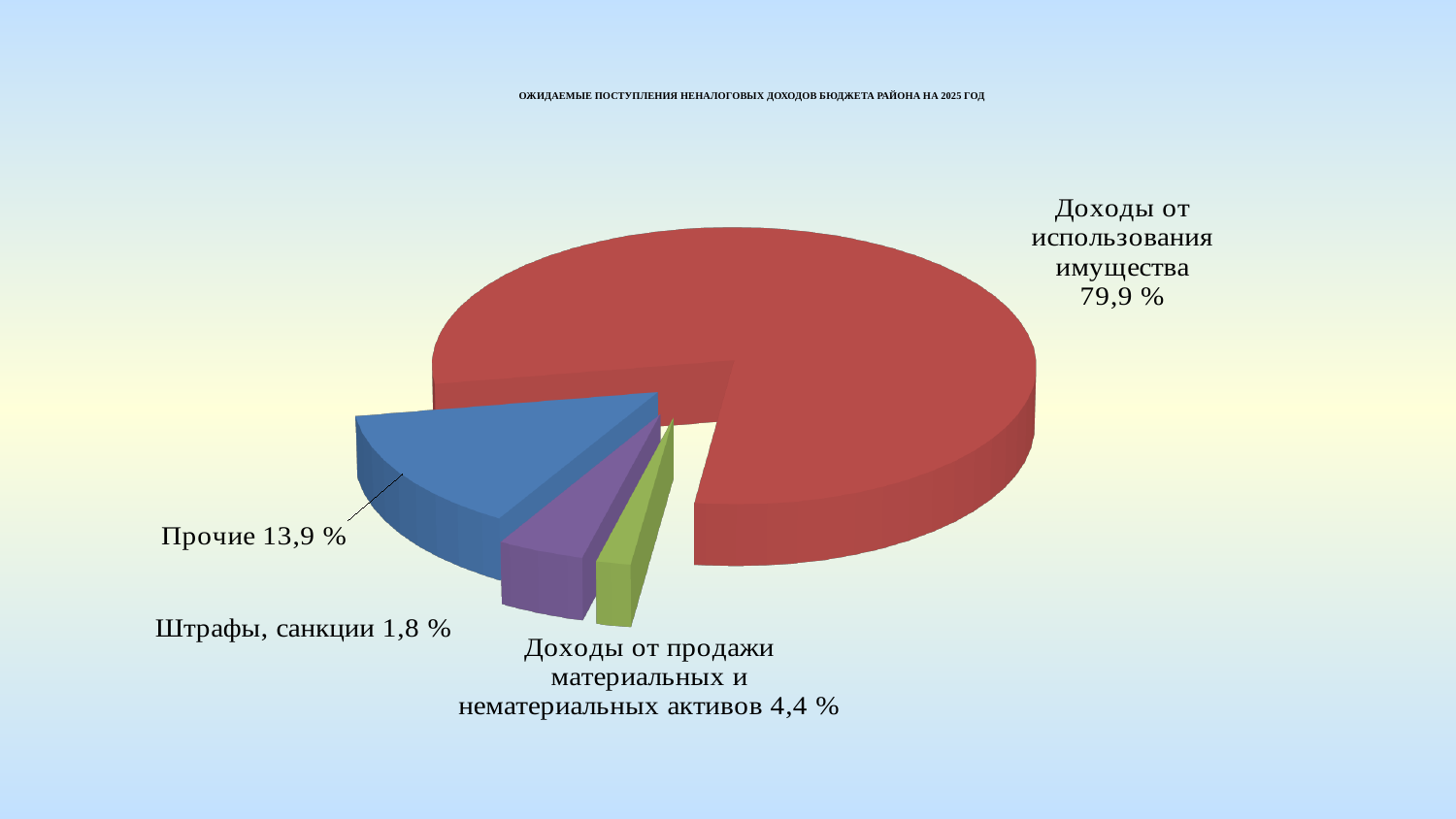
How many slices does the pie chart have? 4 What share of the pie is labelled "Доходы от использования имущества"? 79,9 % Which category has the largest share of the pie? Доходы от использования имущества What colour is the slice for "Доходы от использования имущества"? Red Which category has the smallest share of the pie? Штрафы, санкции What is the difference in percentage points between "Доходы от продажи материальных и нематериальных активов" and "Штрафы, санкции"? 2,6 % What is the value shown for "Доходы от продажи материальных и нематериальных активов"? 4,4 % Which is larger: the share for "Прочие" or the share for "Доходы от продажи материальных и нематериальных активов"? Прочие What is the value shown for "Штрафы, санкции"? 1,8 % What kind of chart is shown on the slide? Pie chart What is the value shown for "Прочие"? 13,9 % What is the difference in percentage points between "Доходы от использования имущества" and "Прочие"? 66,0 %